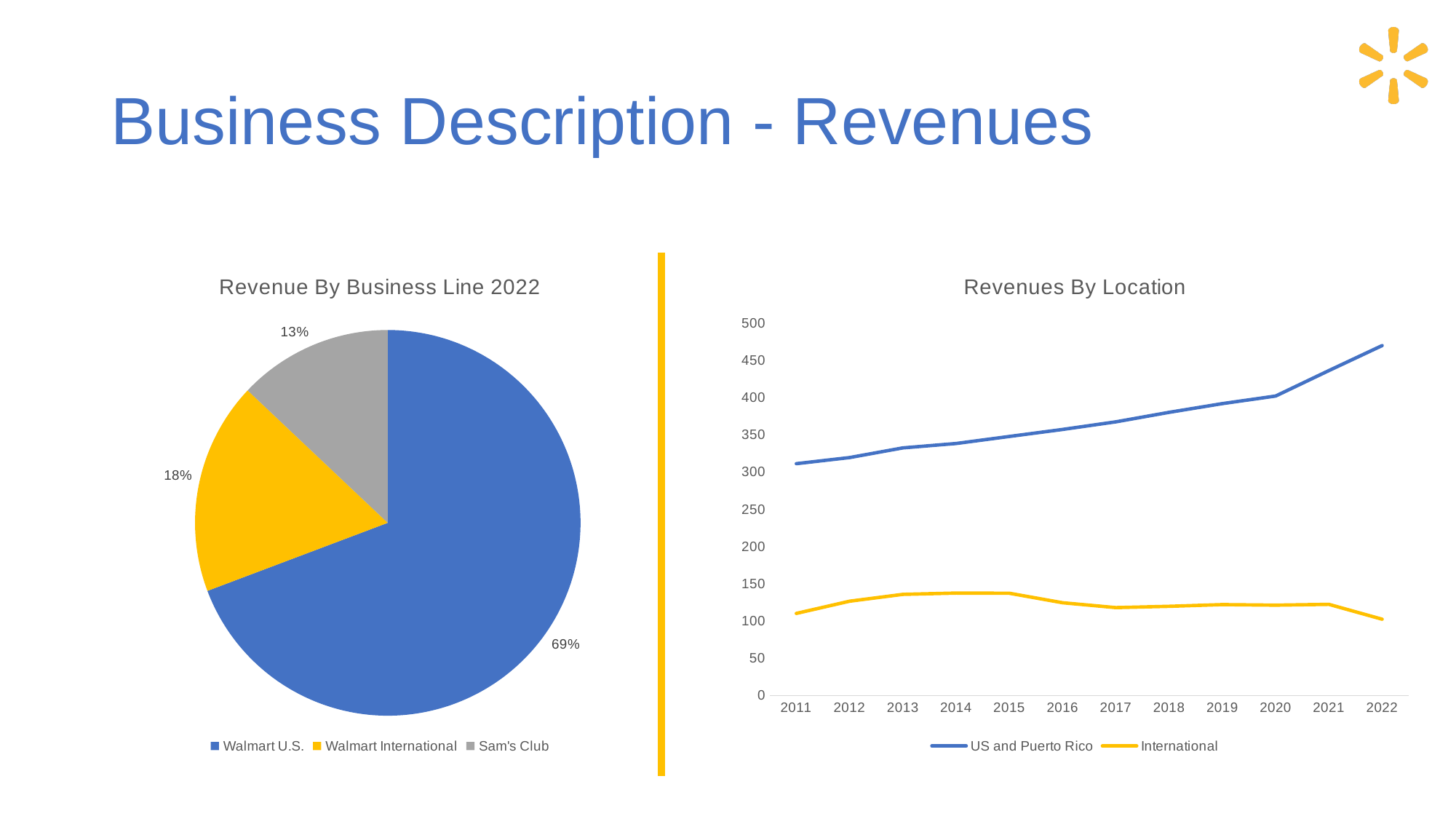
In the 'Revenue By Business Line 2022' chart, which business line has the smallest share? Sam's Club In the 'Revenues By Location' chart, which series is higher in 2022, US and Puerto Rico or International? US and Puerto Rico In the 'Revenue By Business Line 2022' chart, how many slices does the pie have? 3 In the 'Revenue By Business Line 2022' chart, what share of revenue does Sam's Club account for? 13% In the 'Revenue By Business Line 2022' chart, what is the difference in percentage points between Walmart International and Sam's Club? 5 In the 'Revenue By Business Line 2022' chart, which business line has the largest share? Walmart U.S. What kind of chart is 'Revenues By Location'? Line chart In the 'Revenue By Business Line 2022' chart, what share of revenue does Walmart U.S. account for? 69% In the 'Revenues By Location' chart, does the US and Puerto Rico series rise or fall from 2011 to 2022? Rise What kind of chart is 'Revenue By Business Line 2022'? Pie chart In the 'Revenues By Location' chart, is the value for US and Puerto Rico in 2022 greater or less than 450? greater In the 'Revenues By Location' chart, how many series does the legend list? 2